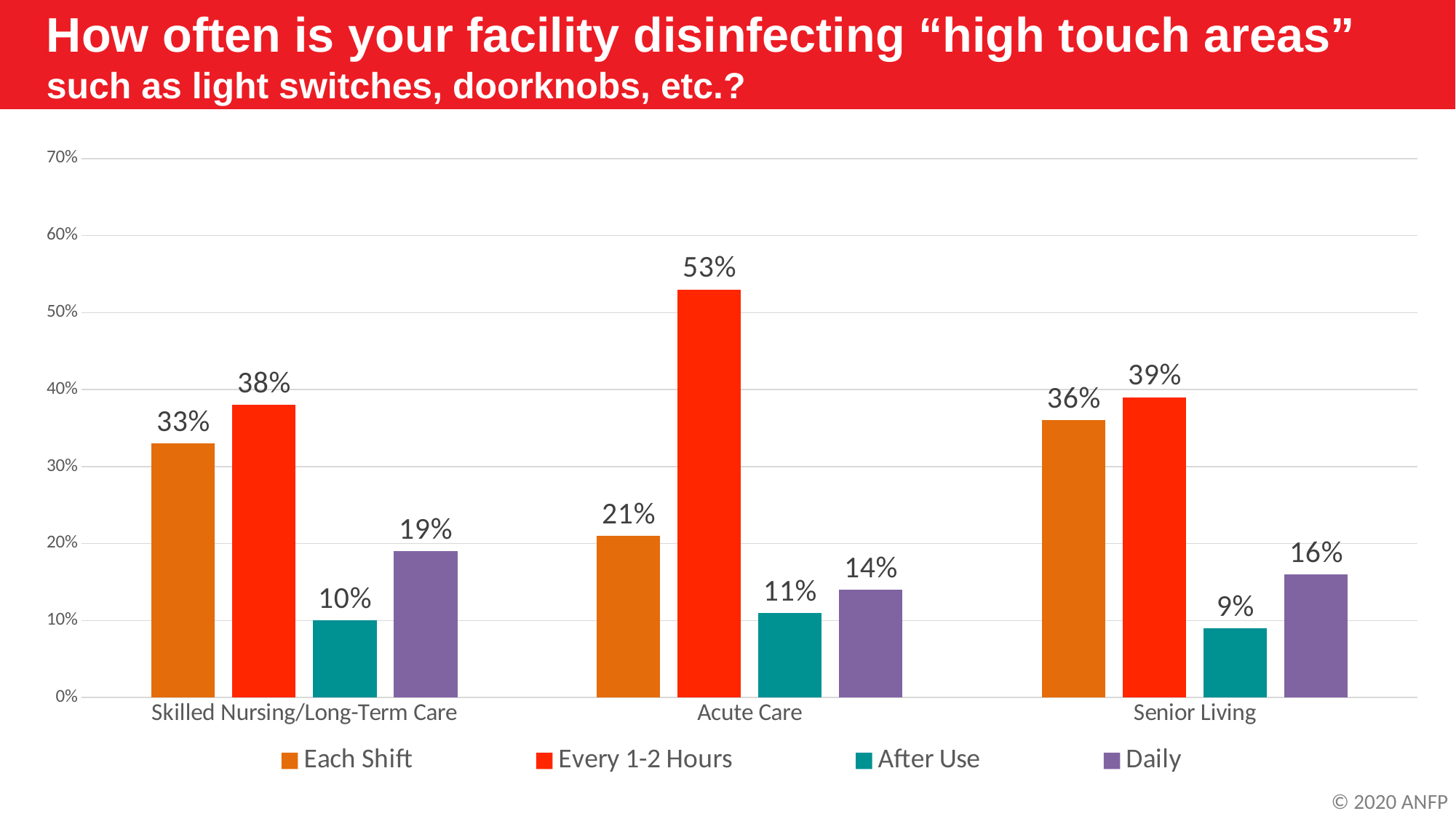
Is the value for Every 1-2 Hours in Acute Care greater or less than 50%? greater How many series does the legend list? 4 What kind of chart is shown on the slide? Bar chart Which facility type has the highest value for Every 1-2 Hours? Acute Care What is the value for Daily in the Skilled Nursing/Long-Term Care category? 19% What is the difference between the Every 1-2 Hours and Each Shift values for Senior Living? 3% What is the value for After Use in the Senior Living category? 9% Which facility type has the lowest value for Each Shift? Acute Care What colour represents the After Use series in the legend? Teal What percentage of Acute Care facilities disinfect high touch areas every 1-2 hours? 53% Which is larger for Skilled Nursing/Long-Term Care: Each Shift or Daily? Each Shift How many facility type categories are shown on the x axis? 3